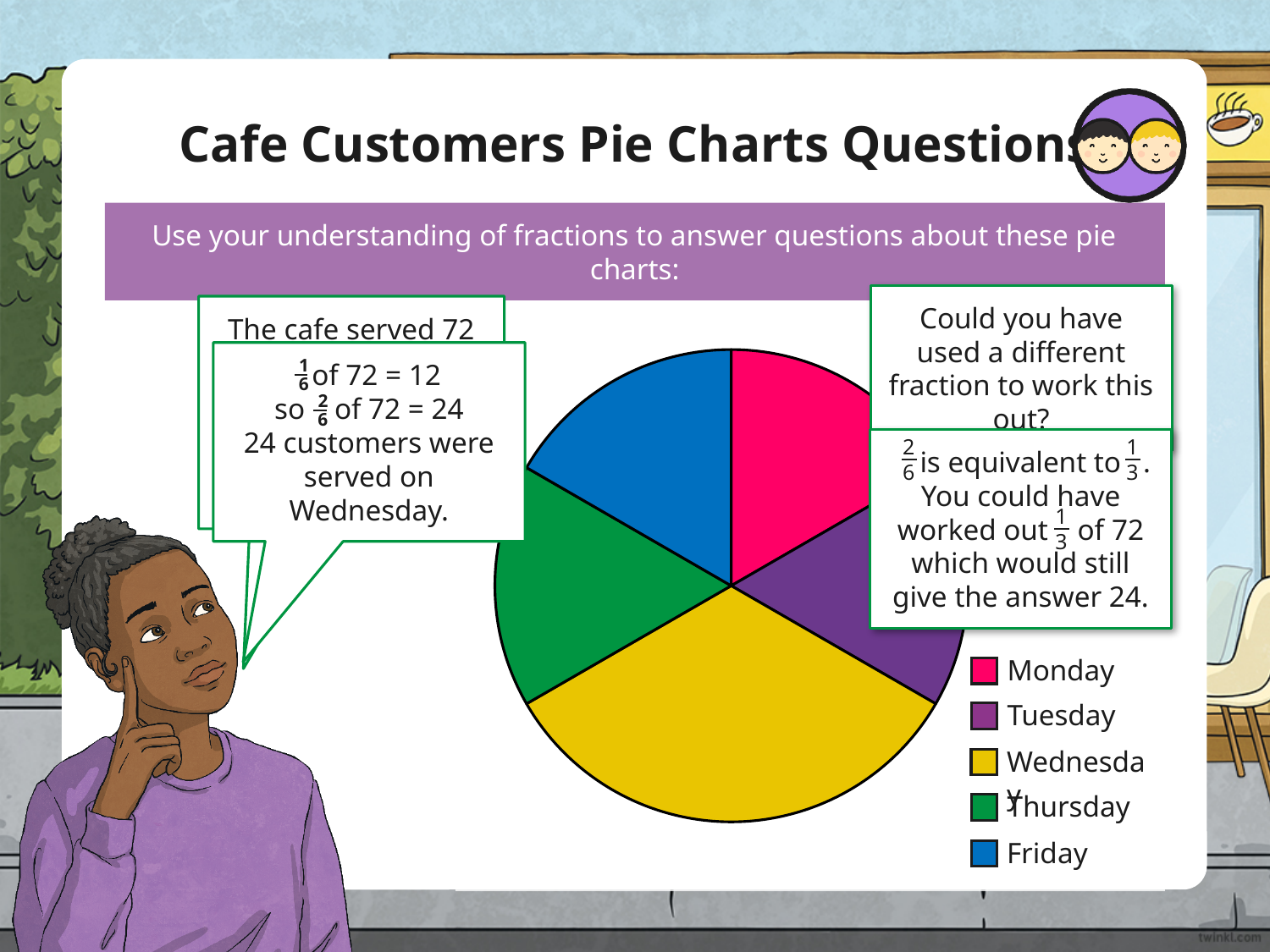
Which slice is larger, Wednesday or Monday? Wednesday How many slices does the pie chart have? 5 Which day is shown in yellow in the pie chart? Wednesday According to the slide, how many customers did the cafe serve in total? 72 Which slice is larger, Wednesday or Friday? Wednesday According to the slide, what fraction of the pie chart does Wednesday represent? 2/6 Which day has the largest slice of the pie chart? Wednesday What kind of chart is shown on the slide? pie chart According to the slide, how many customers were served on Wednesday? 24 Which colour represents Friday in the pie chart? blue How many entries does the legend of the pie chart list? 5